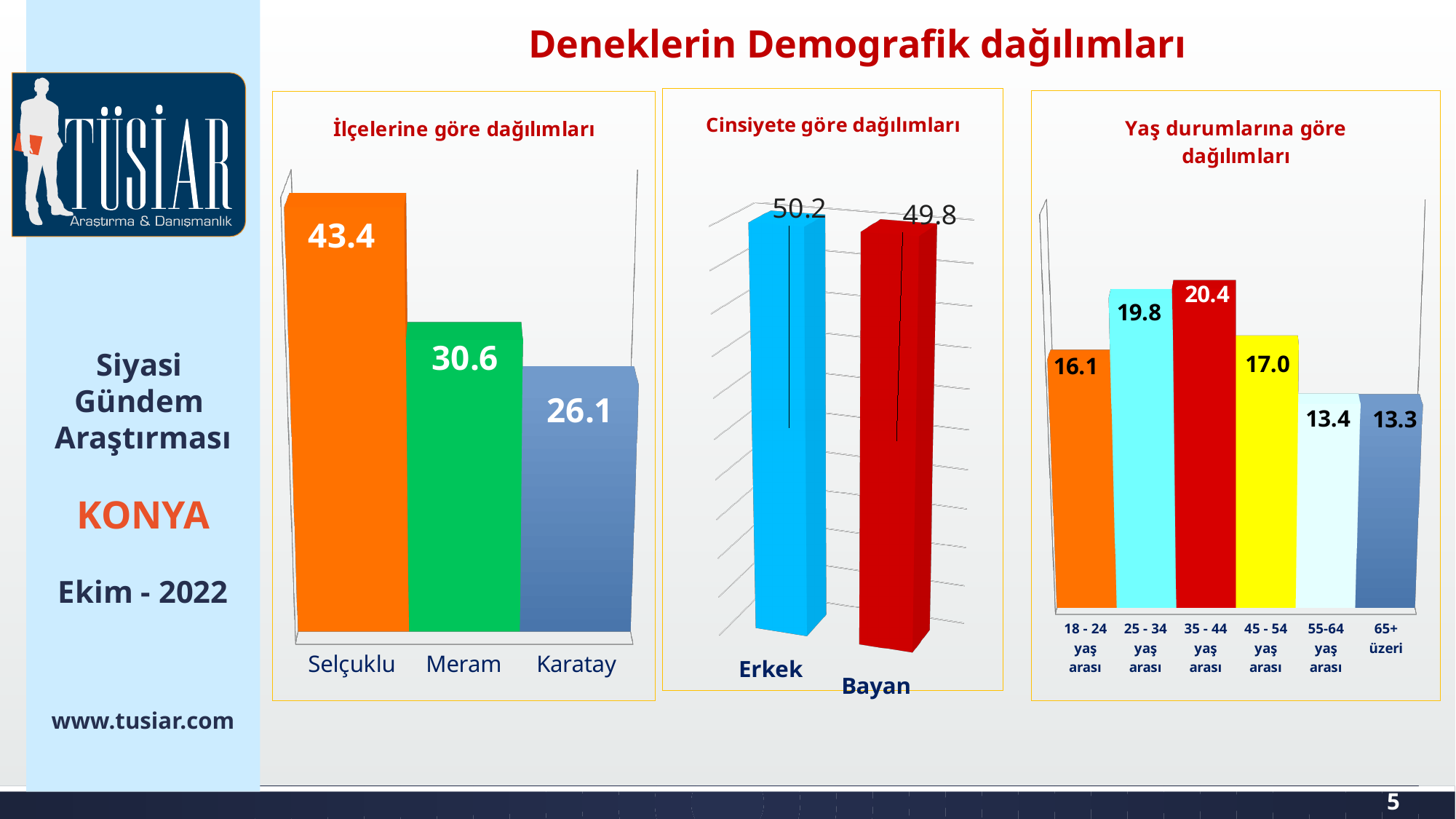
In the 'İlçelerine göre dağılımları' chart, how many districts are shown? 3 In the 'Yaş durumlarına göre dağılımları' chart, what is the difference between the 35 - 44 yaş arası and 18 - 24 yaş arası groups? 4.3 In the 'Yaş durumlarına göre dağılımları' chart, how many age groups are shown? 6 In the 'Yaş durumlarına göre dağılımları' chart, which age group has the highest value? 35 - 44 yaş arası In the 'Cinsiyete göre dağılımları' chart, what is the difference between Erkek and Bayan? 0.4 In the 'Cinsiyete göre dağılımları' chart, what is the value for Bayan? 49.8 In the 'İlçelerine göre dağılımları' chart, what is the difference between Selçuklu and Meram? 12.8 In the 'Cinsiyete göre dağılımları' chart, what colour is the Erkek bar? Light blue In the 'İlçelerine göre dağılımları' chart, which district has the lowest value? Karatay What kind of chart is the 'Yaş durumlarına göre dağılımları' chart? Bar chart In the 'İlçelerine göre dağılımları' chart, what is the value for Selçuklu? 43.4 In the 'Yaş durumlarına göre dağılımları' chart, what is the value for the 45 - 54 yaş arası group? 17.0